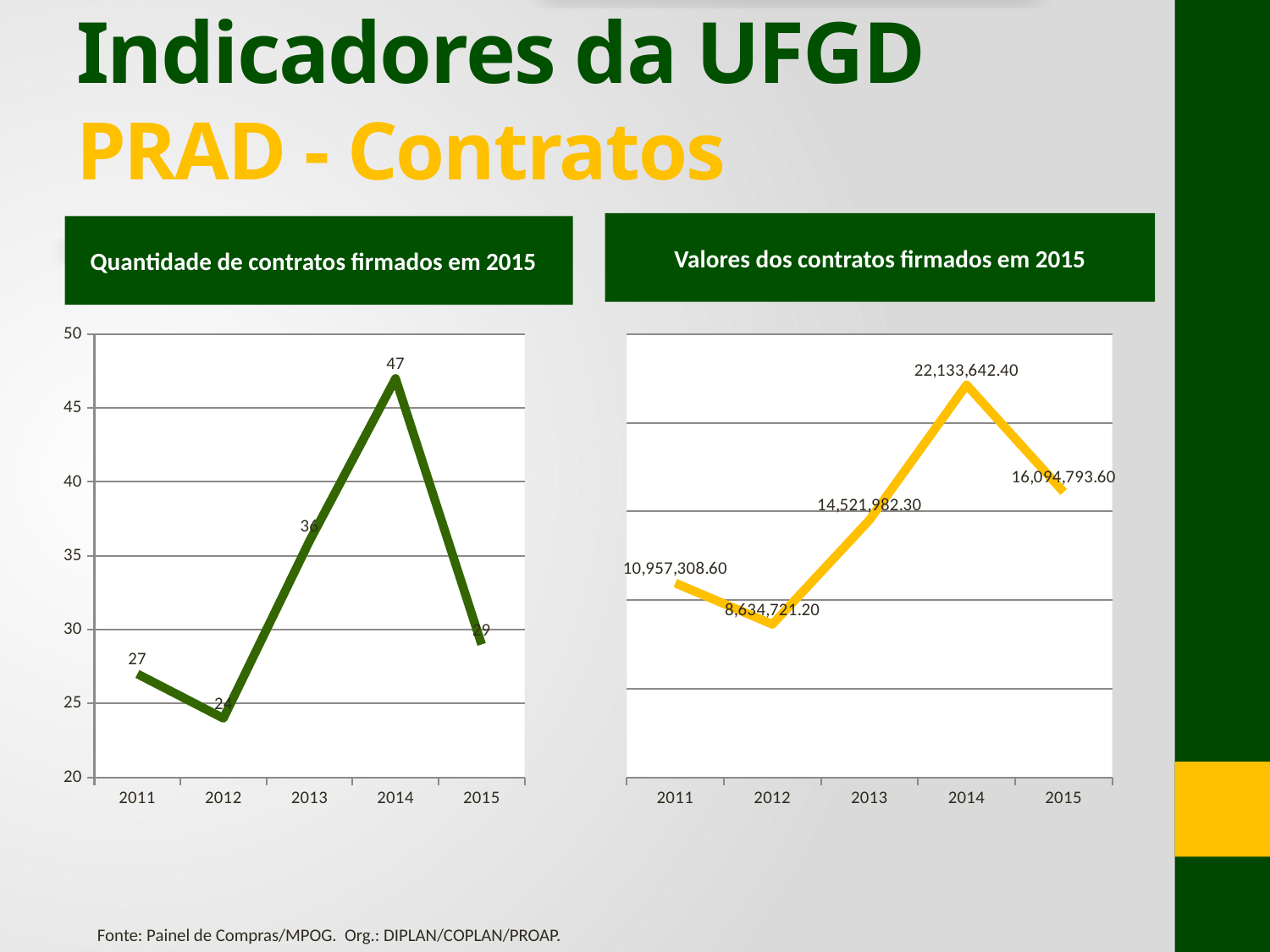
In the chart titled "Quantidade de contratos firmados em 2015", which year has the lowest value? 2012 In the chart titled "Valores dos contratos firmados em 2015", which is larger, the value for 2013 or the value for 2015? 2015 In the chart titled "Quantidade de contratos firmados em 2015", what is the difference between the values for 2014 and 2013? 11 What kind of chart is the chart titled "Quantidade de contratos firmados em 2015"? line chart In the chart titled "Quantidade de contratos firmados em 2015", which year has the highest value? 2014 In the chart titled "Quantidade de contratos firmados em 2015", what is the value for 2011? 27 In the chart titled "Valores dos contratos firmados em 2015", what is the value for 2014? 22,133,642.40 In the chart titled "Quantidade de contratos firmados em 2015", is the value for 2013 greater or less than 35? greater In the chart titled "Quantidade de contratos firmados em 2015", what is the value for 2014? 47 How many years are plotted in the chart titled "Valores dos contratos firmados em 2015"? 5 In the chart titled "Valores dos contratos firmados em 2015", which year has the lowest value? 2012 In the chart titled "Valores dos contratos firmados em 2015", what is the value for 2012? 8,634,721.20